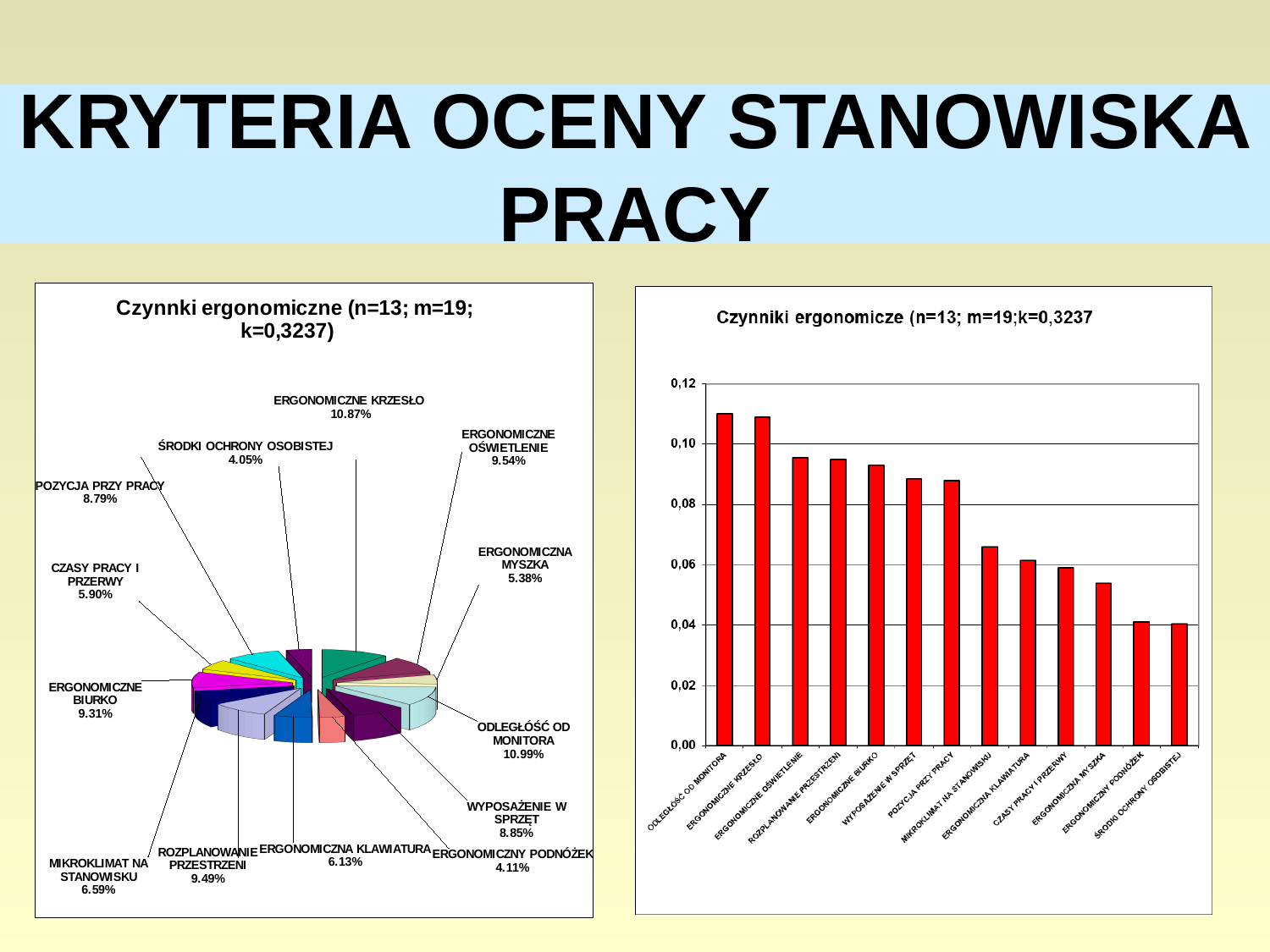
How many categories are shown in the pie chart on the left? 13 In the bar chart on the right, is the value for ŚRODKI OCHRONY OSOBISTEJ greater or less than 0,06? less In the bar chart on the right, do the values rise or fall from left to right along the x axis? Fall In the bar chart on the right, is the value for ODLEGŁOŚĆ OD MONITORA greater or less than 0,10? greater In the bar chart on the right, which category has the tallest bar? ODLEGŁOŚĆ OD MONITORA What kind of chart is the chart on the right of the slide? Bar chart In the pie chart on the left, which category has the smallest share? ŚRODKI OCHRONY OSOBISTEJ In the pie chart on the left, what percentage is shown for ERGONOMICZNA KLAWIATURA? 6.13% In the pie chart on the left, what percentage is shown for ERGONOMICZNE KRZESŁO? 10.87% In the pie chart on the left, which is larger: ERGONOMICZNE BIURKO or WYPOSAŻENIE W SPRZĘT? ERGONOMICZNE BIURKO In the pie chart on the left, which category has the largest share? ODLEGŁOŚĆ OD MONITORA In the pie chart on the left, what is the difference between the shares of ODLEGŁOŚĆ OD MONITORA and ERGONOMICZNY PODNÓŻEK? 6.88%